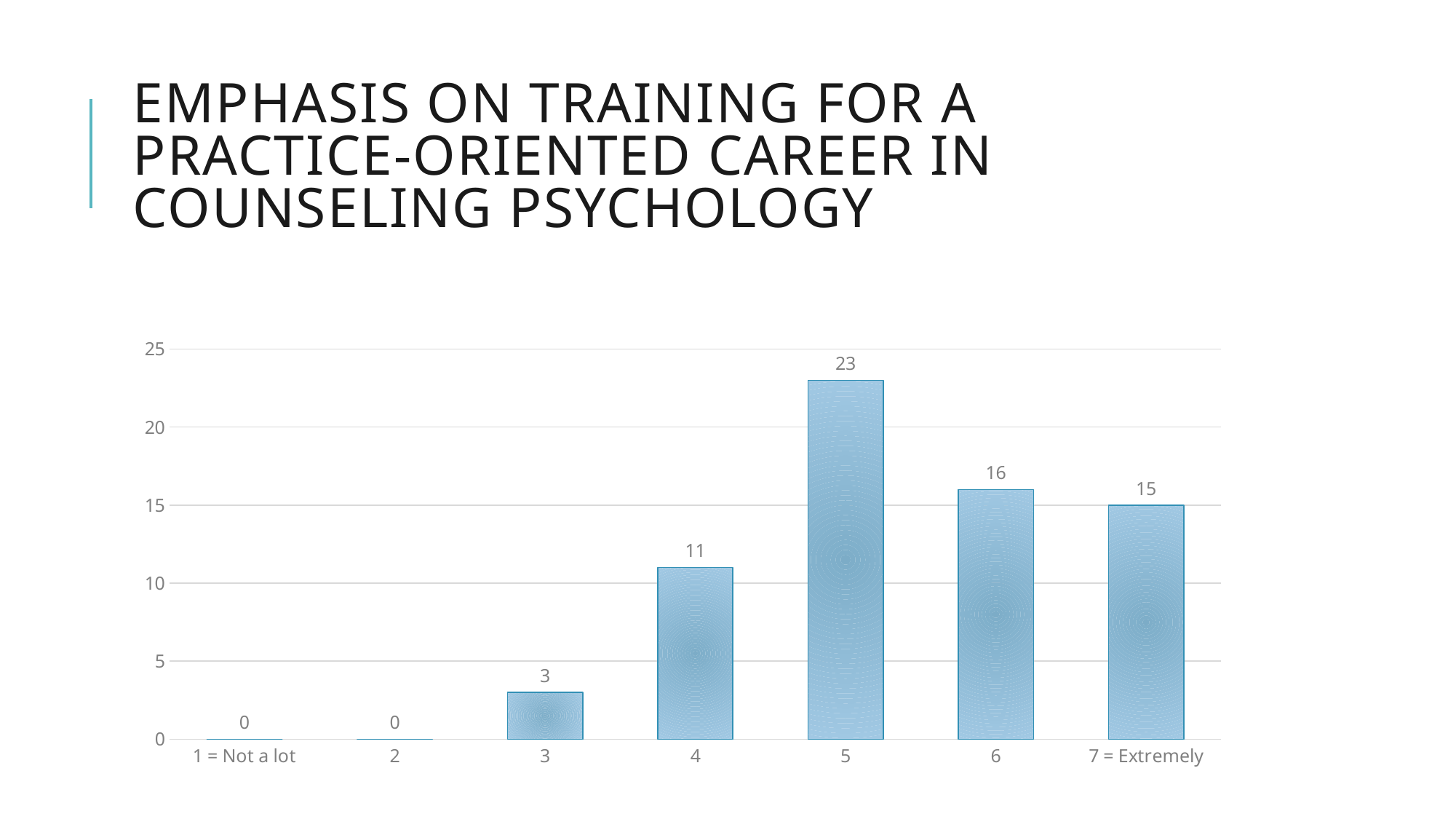
What is the difference between the values for category 4 and category 3? 8 What is the value for category 5? 23 What kind of chart is shown on the slide? bar chart Which category has the highest value? 5 How many categories have a value of 0? 2 How many categories are shown on the x axis? 7 What is the title of the slide? Emphasis on Training for a Practice-Oriented Career in Counseling Psychology Which is larger, the value for category 6 or the value for '7 = Extremely'? 6 What is the value for the category '7 = Extremely'? 15 What is the value for category 3? 3 Is the value for category 4 greater or less than 10? greater What is the difference between the values for category 5 and category 6? 7